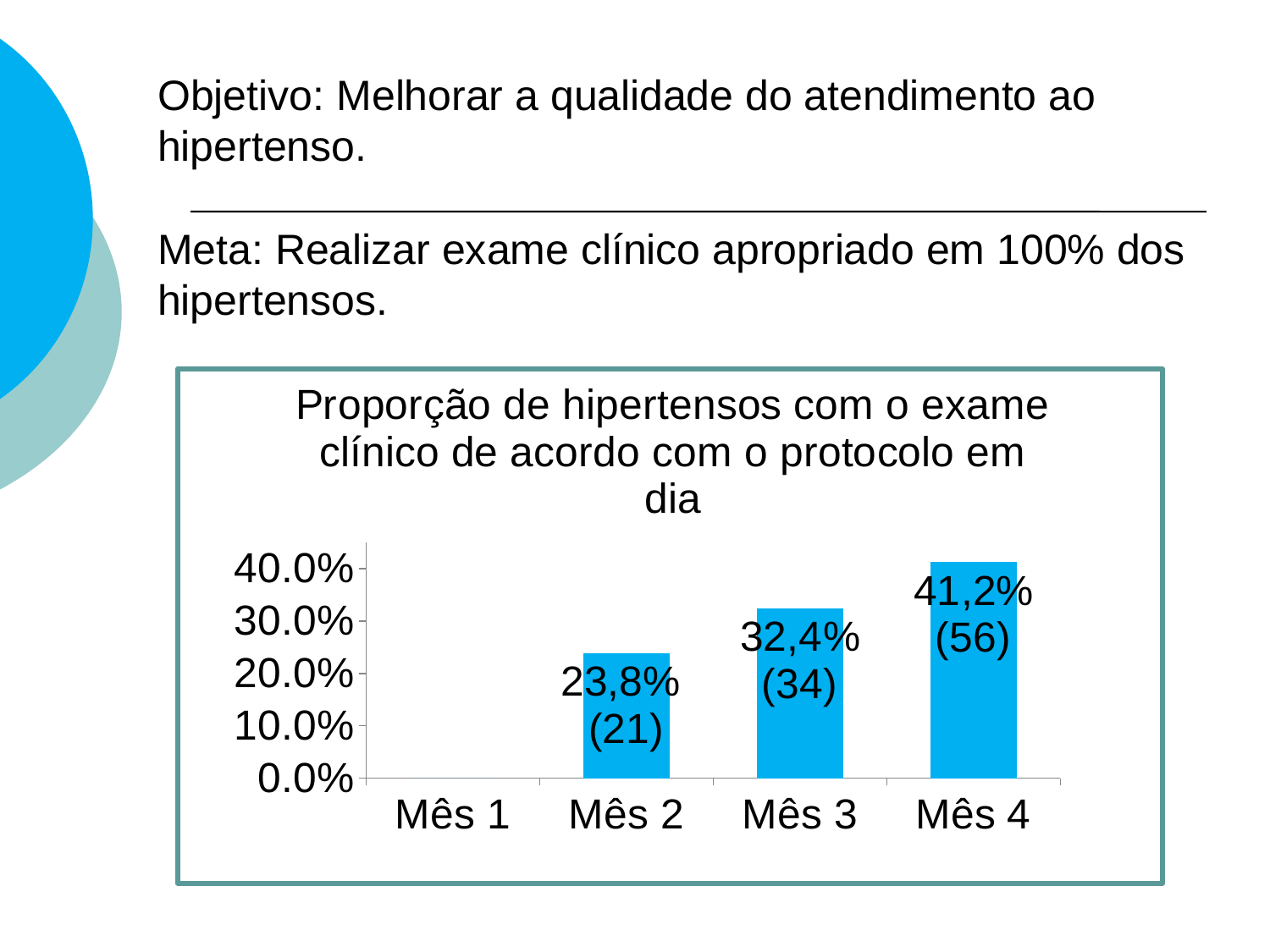
What count is shown in parentheses for Mês 4? 56 What is the value shown for Mês 4? 41,2% Is the value for Mês 4 greater or less than 40.0%? greater What is the title of the chart? Proporção de hipertensos com o exame clínico de acordo com o protocolo em dia What type of chart is shown on the slide? bar chart Which is larger, the value for Mês 3 or the value for Mês 2? Mês 3 Among the months with a bar shown, which has the lowest value? Mês 2 What is the value shown for Mês 3? 32,4% What is the difference in percentage points between Mês 4 and Mês 2? 17,4 Which month has the highest value? Mês 4 What is the value shown for Mês 2? 23,8% How many months are listed on the x axis? 4